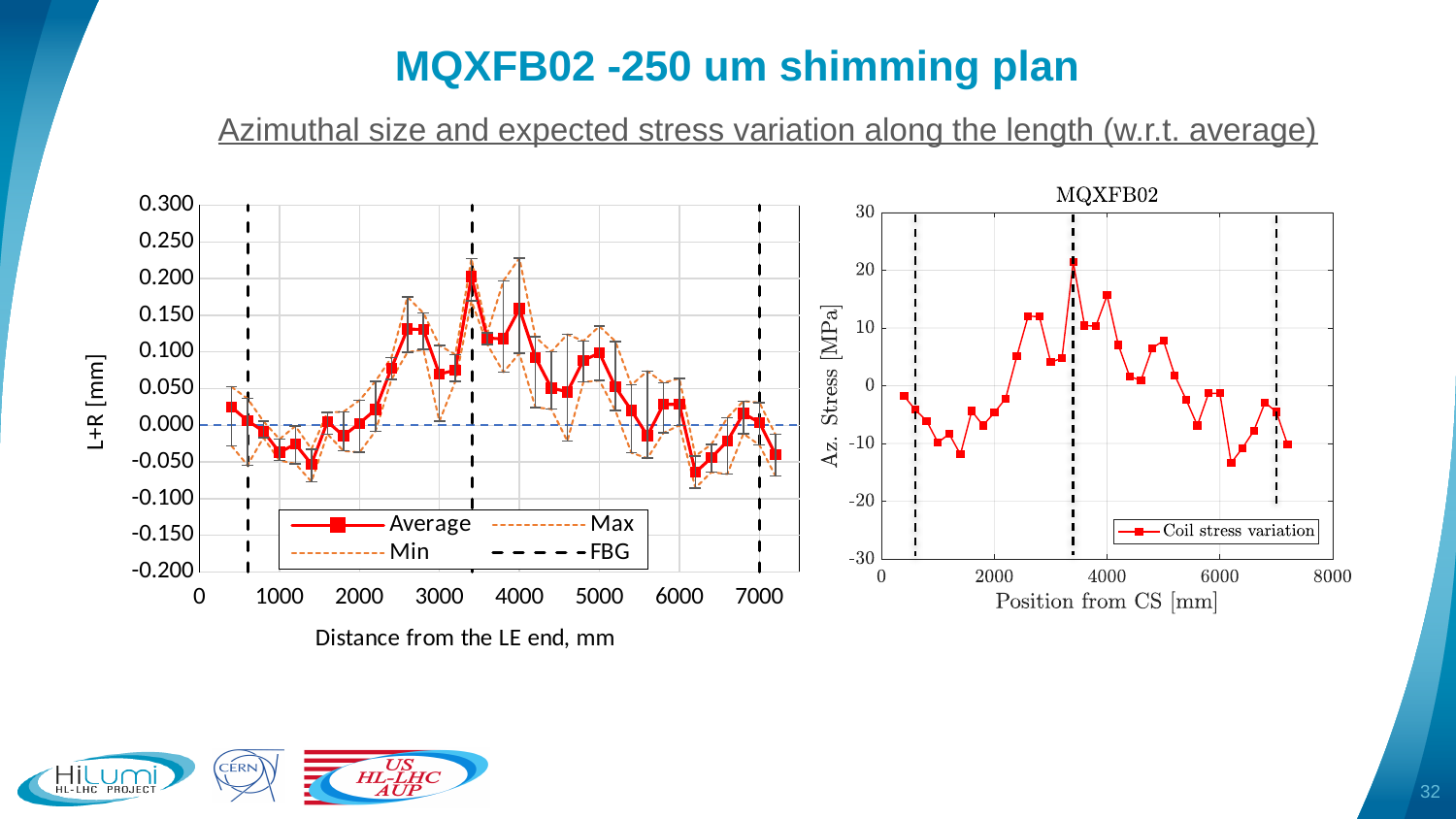
What kind of chart is the right chart titled MQXFB02? Line chart What kind of chart is the left chart (L+R [mm] vs Distance from the LE end)? Line chart How many series does the legend of the right chart (MQXFB02) list? 1 In the left chart, is the Average value near 4000 mm greater or less than 0.100? greater In the left chart, is the peak value of the Average series near 3400 mm greater or less than 0.150? greater In the right chart (MQXFB02), is the Coil stress variation value near 6200 mm greater or less than -10? less What is the name of the series shown in the legend of the right chart (MQXFB02)? Coil stress variation What is the y-axis label of the right chart (MQXFB02)? Az. Stress [MPa] How many series does the legend of the left chart list? 4